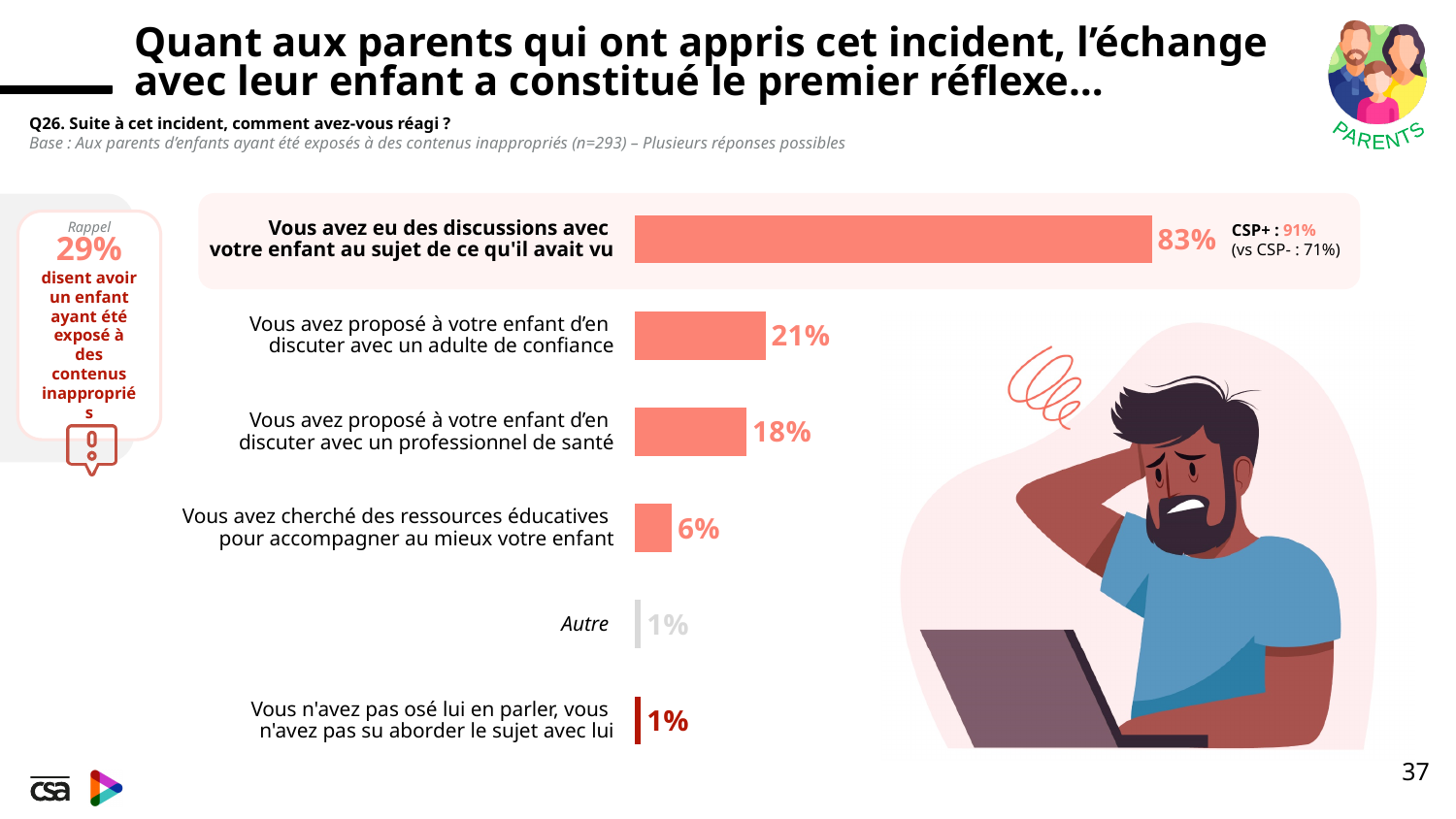
What type of chart is shown on the slide? Bar chart What percentage of parents answered 'Autre'? 1% What percentage of parents proposed that their child discuss with a trusted adult? 21% Which is larger: the share who looked for educational resources or the share who proposed a health professional? Proposed a health professional (18%) What percentage of parents proposed that their child discuss with a health professional? 18% What is the difference in percentage points between having discussions with the child (83%) and proposing a trusted adult (21%)? 62 What percentage of parents said they had discussions with their child about what they had seen? 83% What is the CSP+ value shown next to the top bar? 91% Which response has the highest percentage? Vous avez eu des discussions avec votre enfant au sujet de ce qu'il avait vu What is the difference in percentage points between proposing a trusted adult and proposing a health professional? 3 What percentage of parents looked for educational resources to support their child? 6% How many response categories are shown in the bar chart? 6